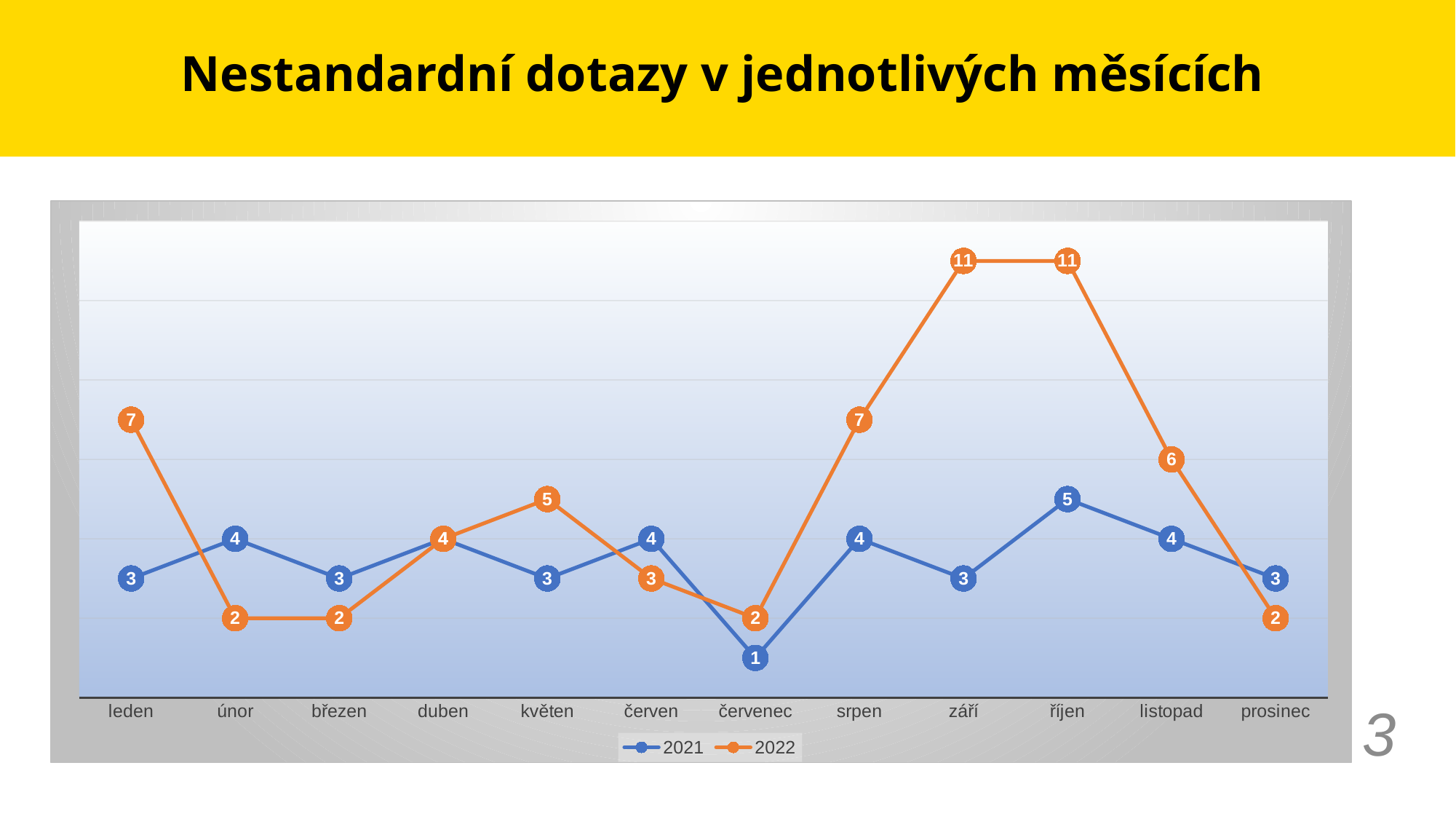
What is the value for 2021 in červenec? 1 What is the value for 2022 in leden? 7 In which month is the 2021 value lowest? červenec Which series has the larger value in květen, 2021 or 2022? 2022 What is the value for 2022 in září? 11 What is the difference between the 2022 and 2021 values in srpen? 3 How many months are shown on the x axis? 12 How many series does the legend list? 2 In which month is the 2021 value highest? říjen Does the 2022 series rise or fall from říjen to prosinec? fall What is the title of the slide? Nestandardní dotazy v jednotlivých měsících What type of chart is shown on the slide? line chart